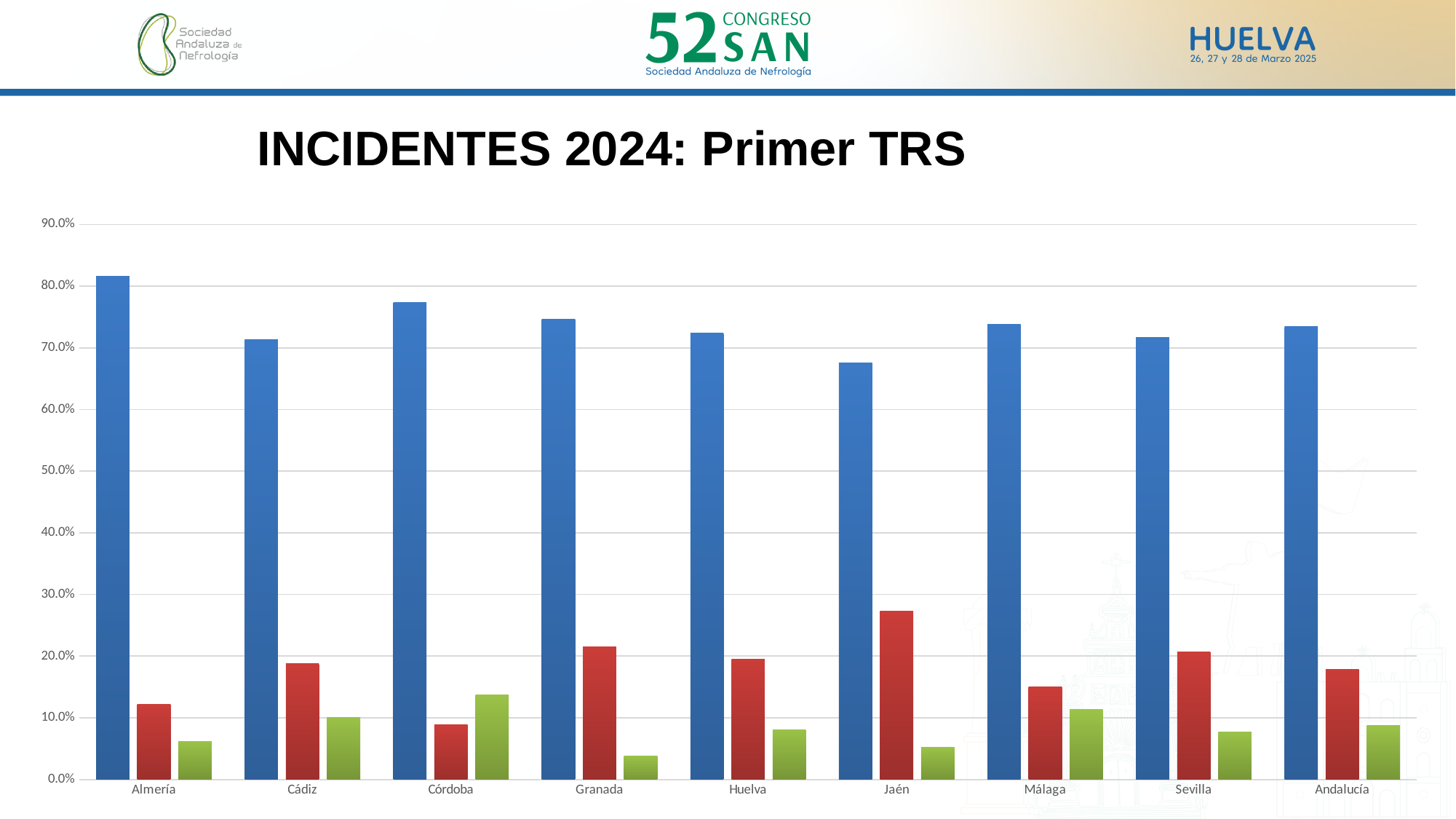
What kind of chart is shown on the slide? bar chart How many categories are shown on the x axis of the chart? 9 How many bars are plotted for each category in the chart? 3 Which category has the shortest blue bar? Jaén Is the red bar for Jaén greater or less than 20.0%? greater What is the title of the chart on the slide? INCIDENTES 2024: Primer TRS Is the blue bar for Almería larger or smaller than the blue bar for Jaén? larger Which category has the shortest red bar? Córdoba Is the blue bar for Jaén greater or less than 70.0%? less Which category has the shortest green bar? Granada Which category has the tallest blue bar? Almería Which category has the tallest red bar? Jaén